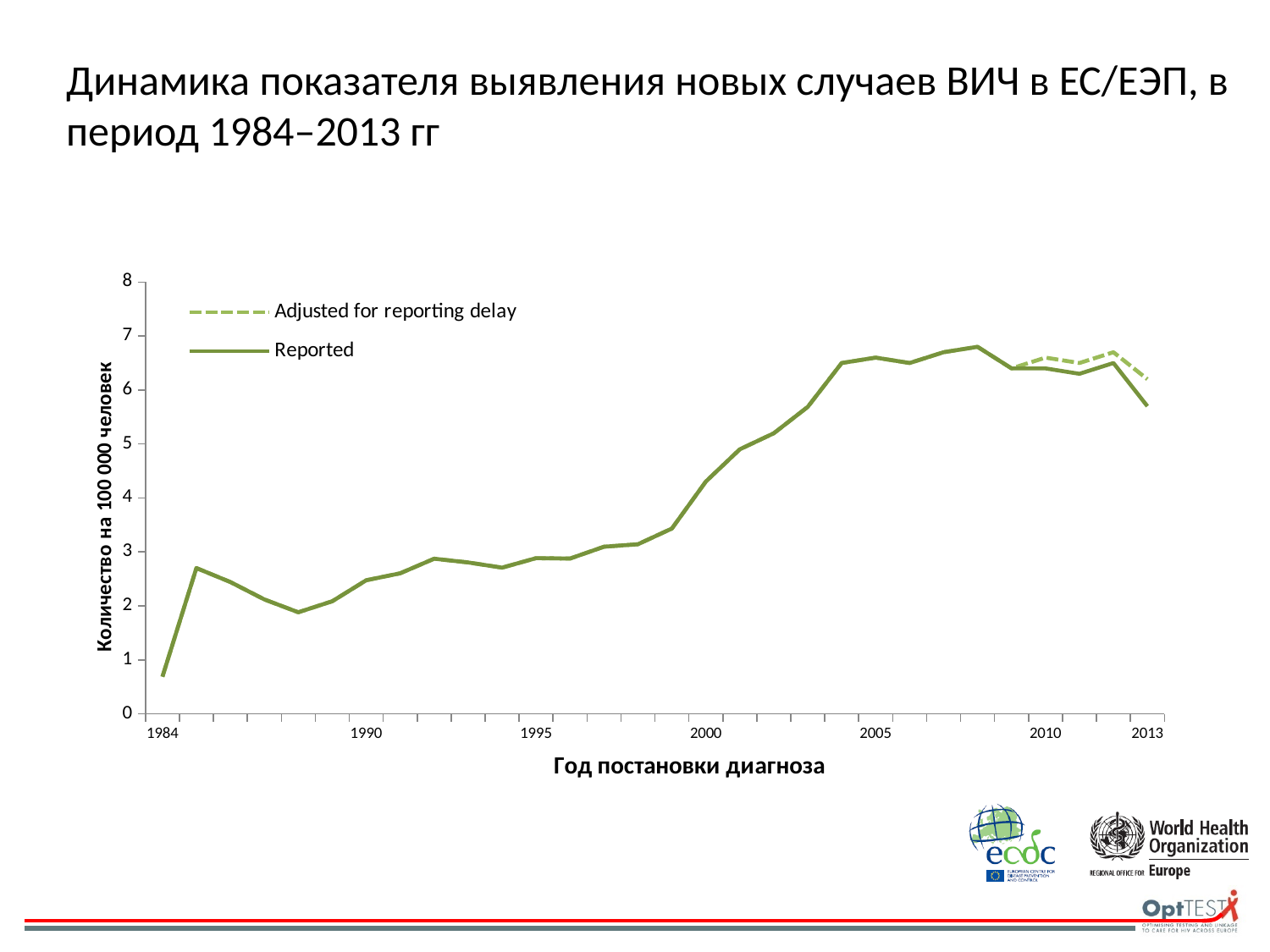
What is the title of the x axis? Год постановки диагноза What kind of chart is shown on the slide? line chart Which year has the lowest Reported value? 1984 Is the Reported value for 2005 greater or less than 6? greater Is the Reported value for 2013 greater or less than 6? less Is the Reported value for 1984 greater or less than 1? less Which series is drawn with a dashed line? Adjusted for reporting delay Does the Reported line rise or fall between 1999 and 2004? rise How many series does the legend list? 2 Which is larger, the Reported value for 2000 or for 1990? 2000